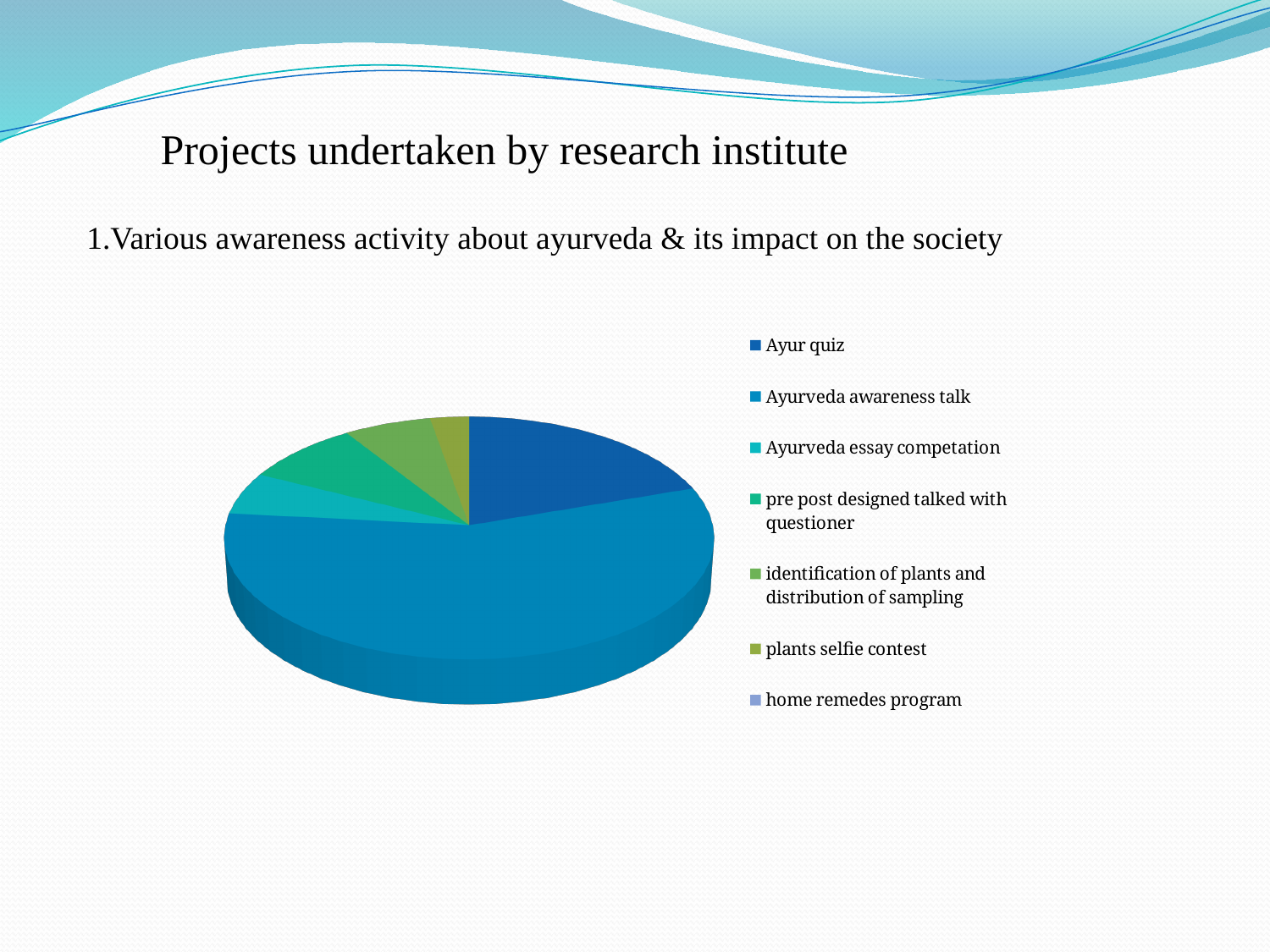
Which category has the largest slice of the pie chart? Ayurveda awareness talk Which slice is larger, Ayur quiz or Ayurveda essay competation? Ayur quiz What kind of chart is shown on the slide? pie chart What is the first category listed in the legend of the pie chart? Ayur quiz Which slice is larger, pre post designed talked with questioner or Ayurveda awareness talk? Ayurveda awareness talk Which slice is larger, Ayurveda awareness talk or Ayur quiz? Ayurveda awareness talk How many categories does the legend of the pie chart list? 7 What is the last category listed in the legend of the pie chart? home remedes program